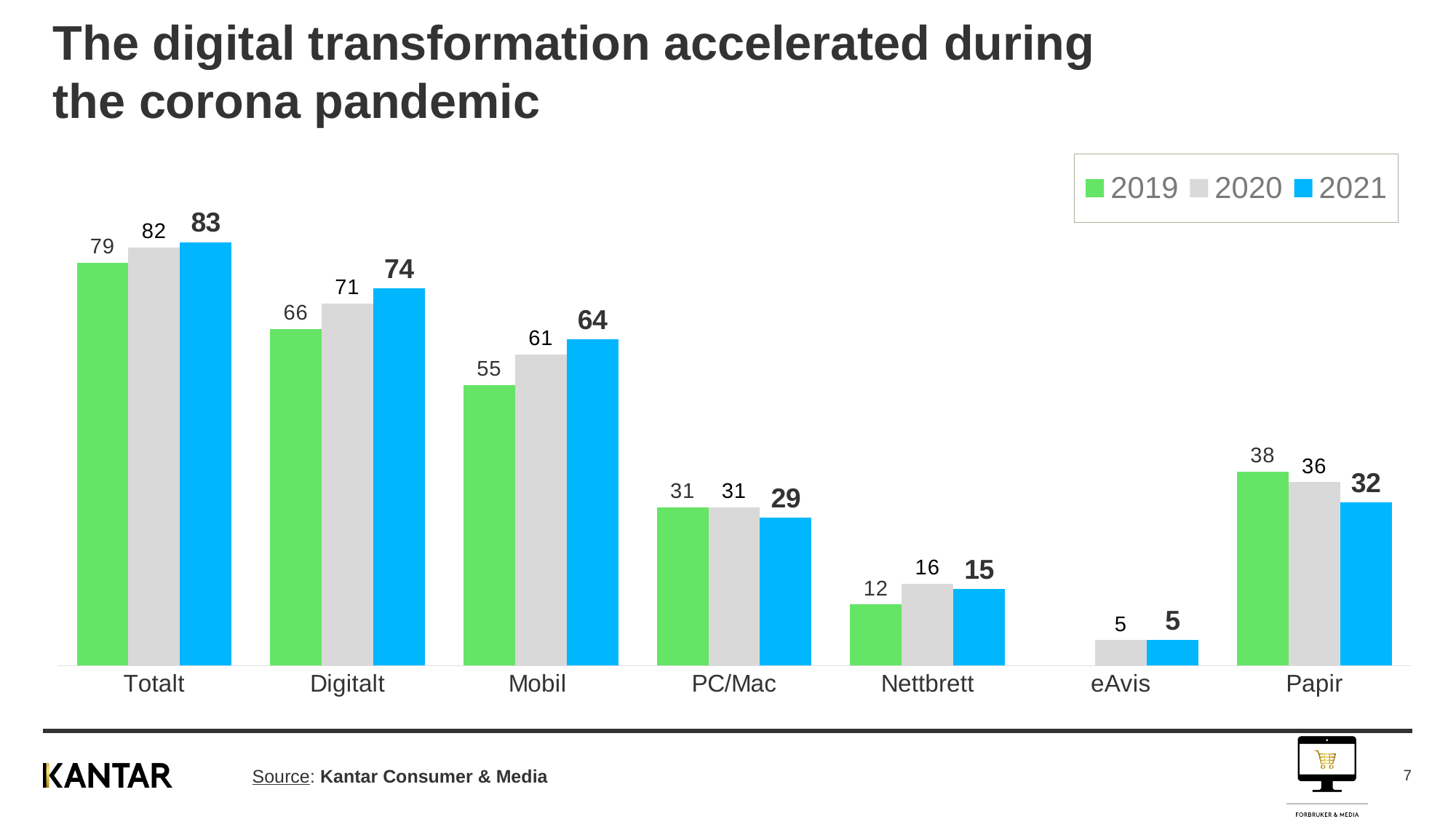
What is the 2021 value for Digitalt? 74 What is the difference between the 2021 and 2019 values for Mobil? 9 How many categories are shown on the x axis? 7 Which category has the lowest 2021 value? eAvis Which is larger for Papir: the 2019 value or the 2021 value? 2019 What is the 2019 value for Mobil? 55 Which category has the highest 2021 value? Totalt What kind of chart is shown on the slide? Bar chart Which series is shown in blue in the legend? 2021 What is the 2020 value for Nettbrett? 16 Do the values for Digitalt rise or fall from 2019 to 2021? Rise How many series does the legend list? 3